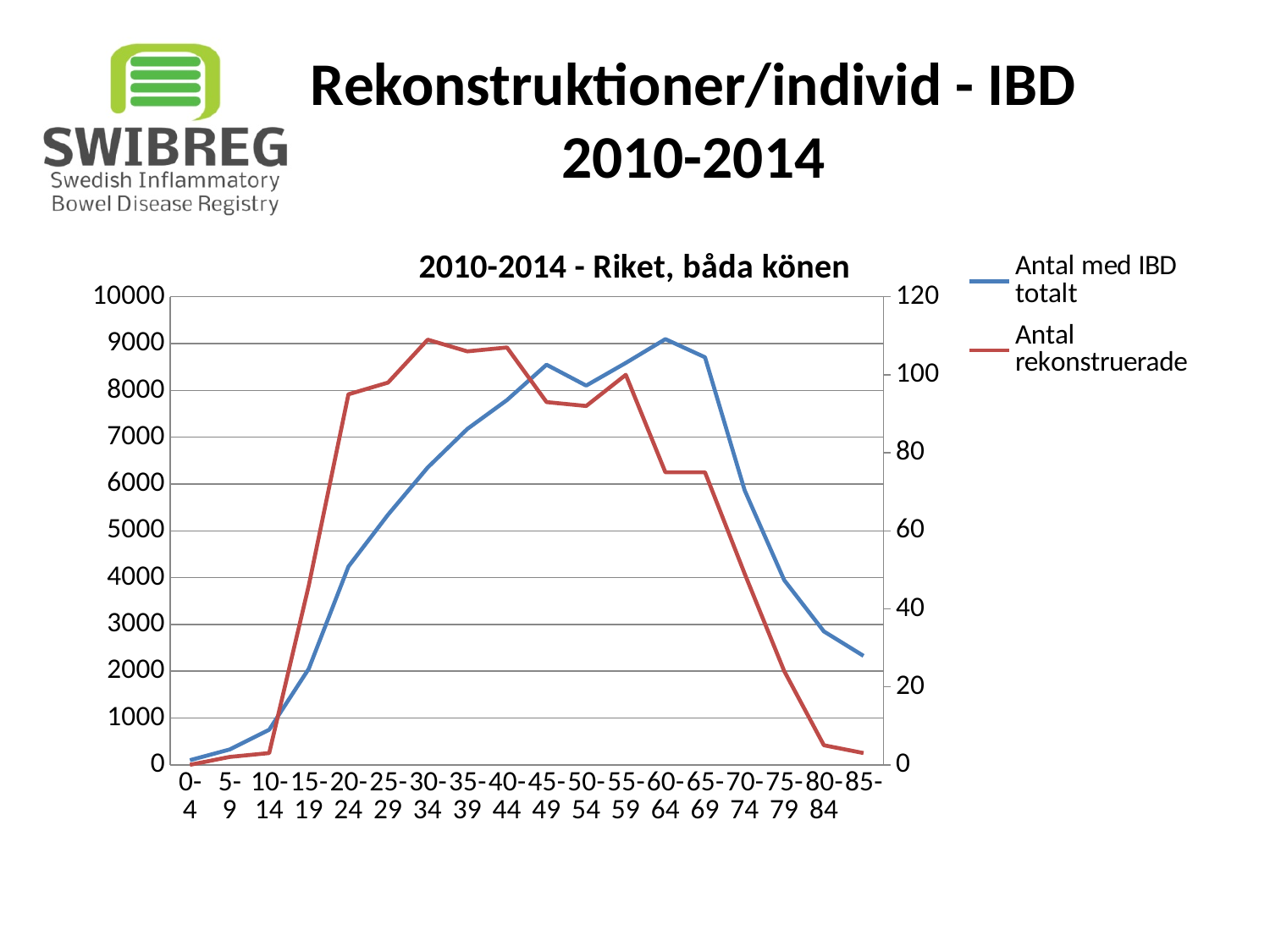
For which age group is 'Antal med IBD totalt' highest? 60-64 Is the value of 'Antal rekonstruerade' for 30-34 greater or less than 100? greater Is the value of 'Antal rekonstruerade' for 80-84 greater or less than 20? less What kind of chart is shown on the slide? line chart Is the value of 'Antal med IBD totalt' for 85- greater or less than 2000? greater How many series does the chart legend list? 2 Which colour is used for the 'Antal rekonstruerade' series? red Does 'Antal med IBD totalt' rise or fall from 60-64 to 85-? fall Which is larger for 'Antal med IBD totalt': the value for 25-29 or the value for 75-79? 25-29 What is the title printed above the chart? 2010-2014 - Riket, båda könen For which age group is 'Antal med IBD totalt' lowest? 0-4 How many age-group categories are plotted along the x axis? 18